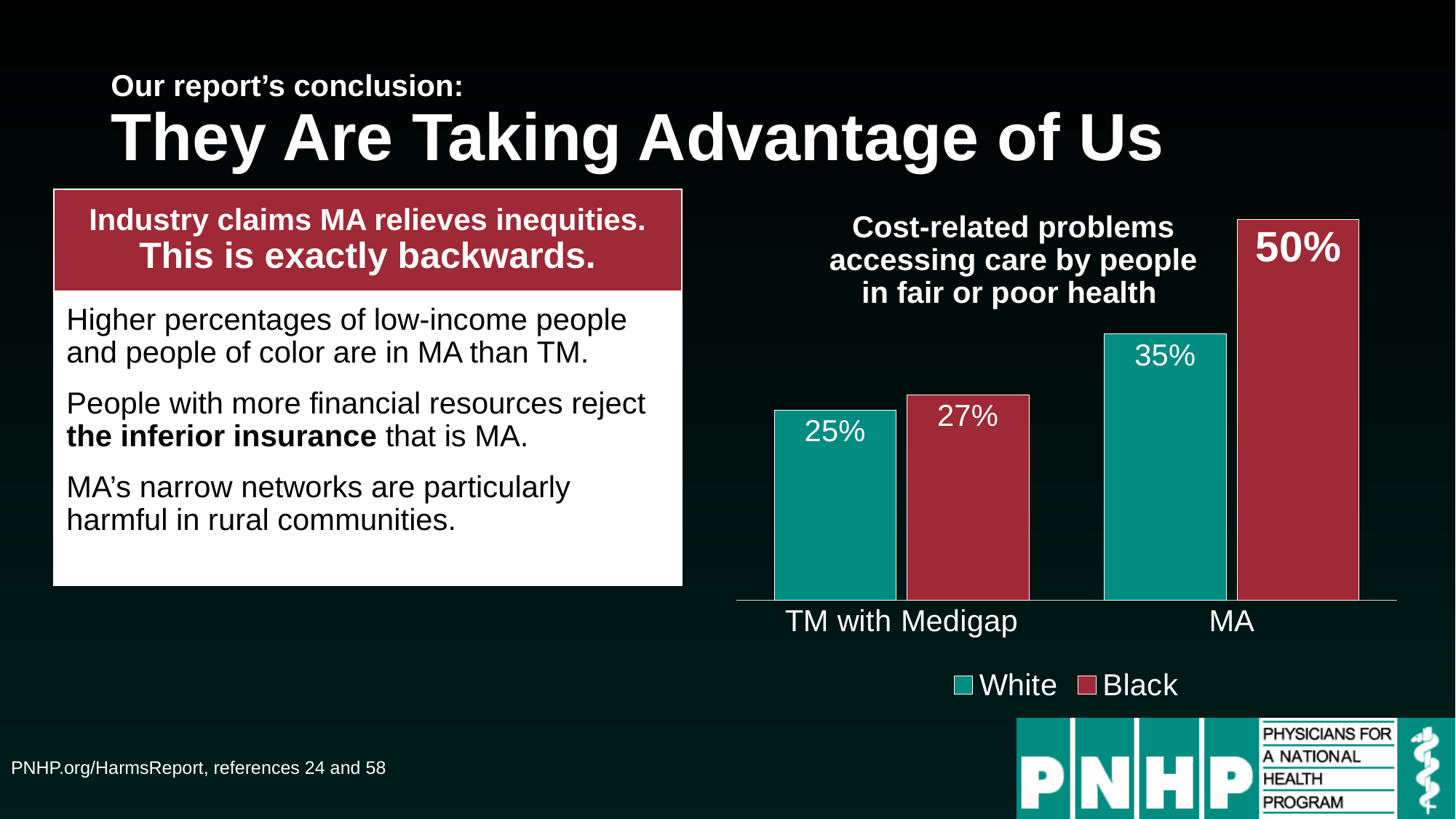
Which group and plan combination has the highest value? Black, MA Which group and plan combination has the lowest value? White, TM with Medigap How many categories are shown on the x axis? 2 What is the difference between the Black values for MA and TM with Medigap? 23% What is the value for Black people with TM with Medigap? 27% How many series does the legend list? 2 What kind of chart is shown? Bar chart What is the value for Black people in MA? 50% What is the value for White people with TM with Medigap? 25% What is the difference between the Black and White values for MA? 15% Which is larger, the White value for MA or the Black value for TM with Medigap? White value for MA What is the value for White people in MA? 35%